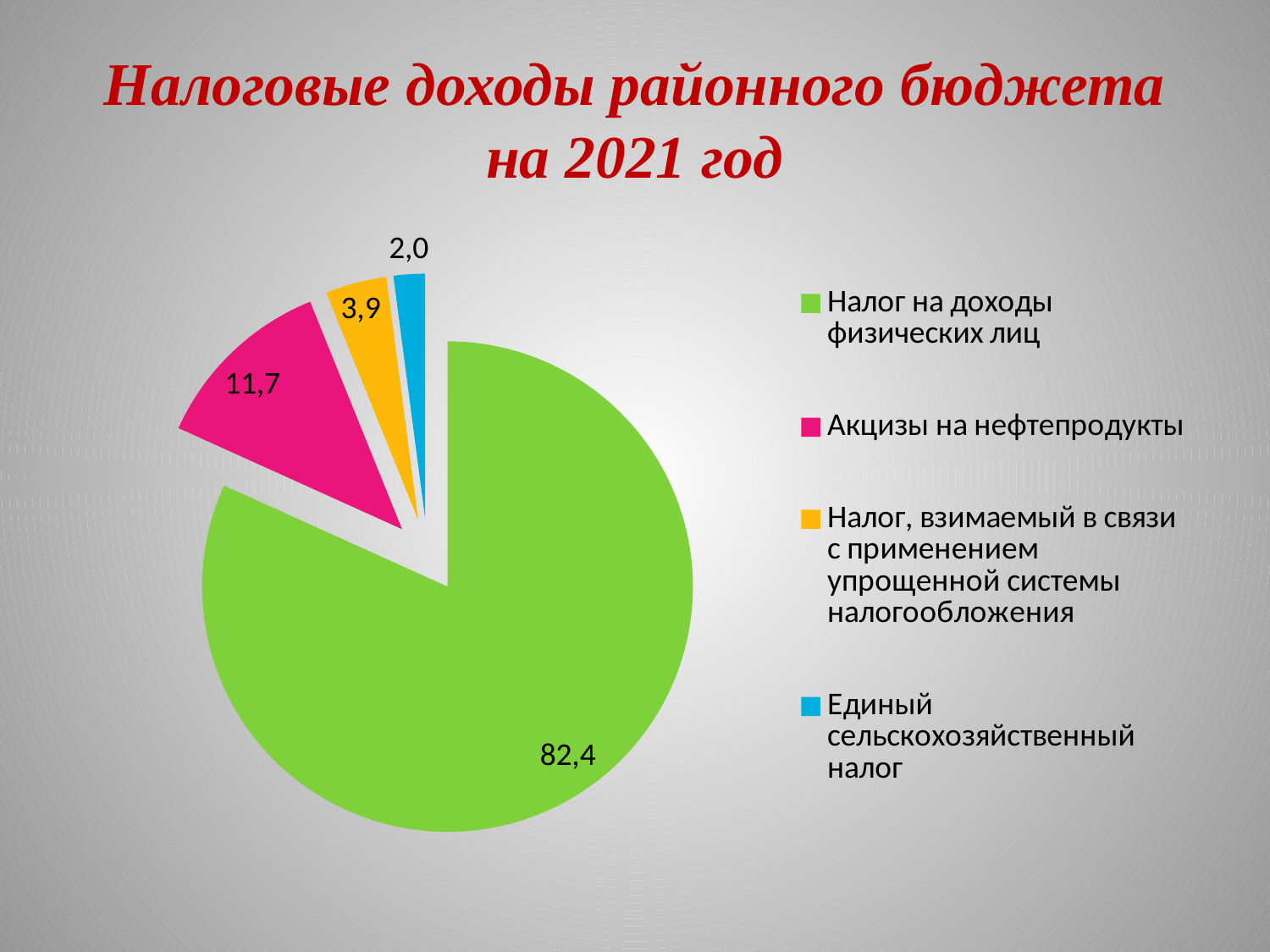
How many slices does the pie chart have? 4 Which category has the smallest slice of the pie? Единый сельскохозяйственный налог What kind of chart is shown on the slide? pie chart Which is larger: the value for Акцизы на нефтепродукты or the value for Налог, взимаемый в связи с применением упрощенной системы налогообложения? Акцизы на нефтепродукты Which category has the largest slice of the pie? Налог на доходы физических лиц What is the value for Единый сельскохозяйственный налог? 2,0 What is the title of the slide? Налоговые доходы районного бюджета на 2021 год What is the difference between the values for Акцизы на нефтепродукты and Единый сельскохозяйственный налог? 9,7 What is the value for Налог на доходы физических лиц? 82,4 What is the value for Налог, взимаемый в связи с применением упрощенной системы налогообложения? 3,9 What is the value for Акцизы на нефтепродукты? 11,7 What is the difference between the values for Налог на доходы физических лиц and Акцизы на нефтепродукты? 70,7